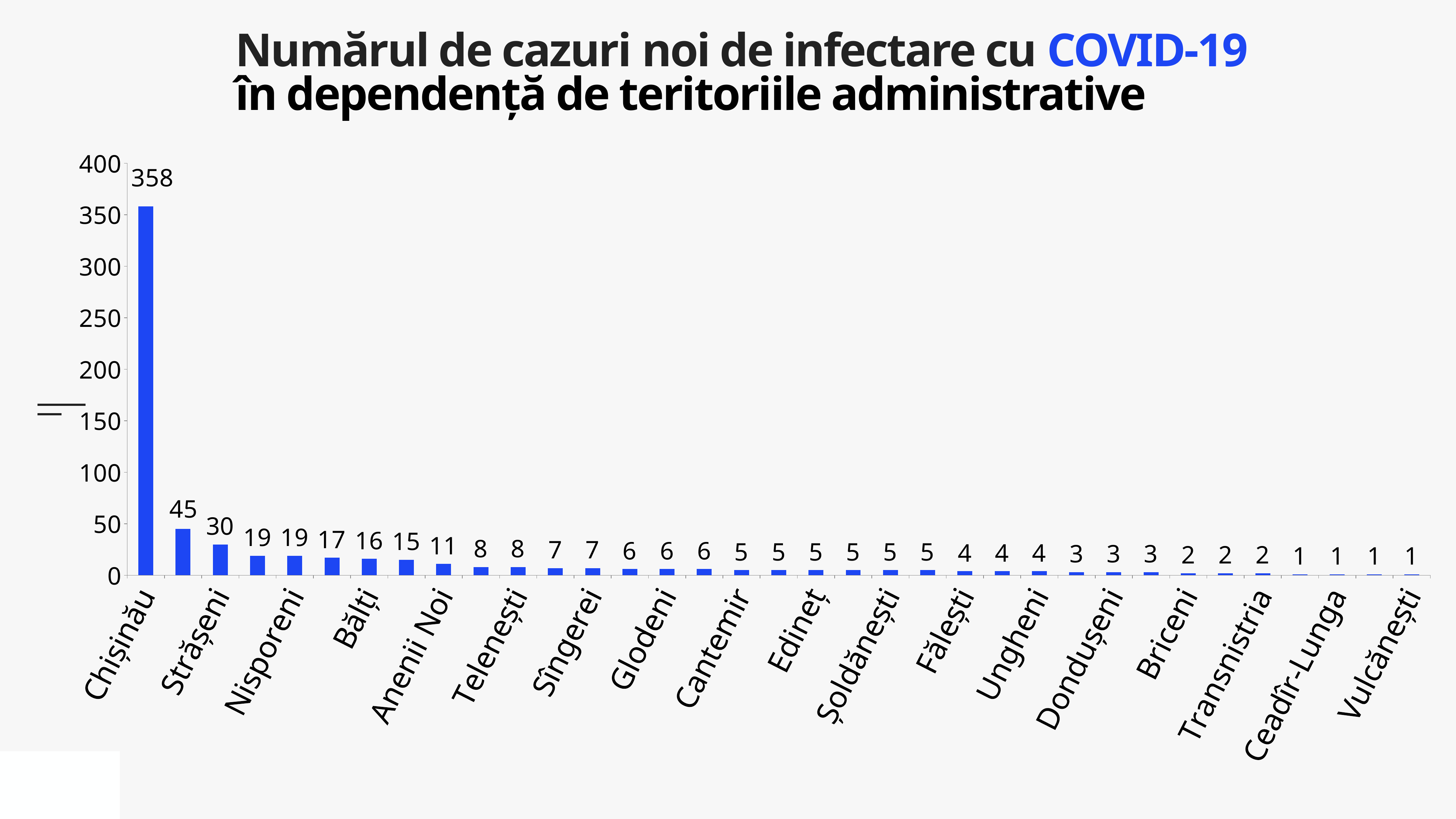
Which territory has the highest number of new COVID-19 cases? Chișinău Do the values rise or fall moving from left to right along the x axis? fall What is the highest tick value shown on the vertical axis? 400 What kind of chart is shown on the slide? bar chart What is the value of the second-tallest bar in the chart? 45 Is the value for Chișinău greater or less than 300? greater How many new COVID-19 cases are shown for Chișinău? 358 What colour are the bars in the chart? blue What is the difference between the tallest bar (358) and the second-tallest bar (45)? 313 What is the smallest value shown on any bar in the chart? 1 Is the value for Chișinău greater or less than 350? greater How many bars are plotted in the chart? 35